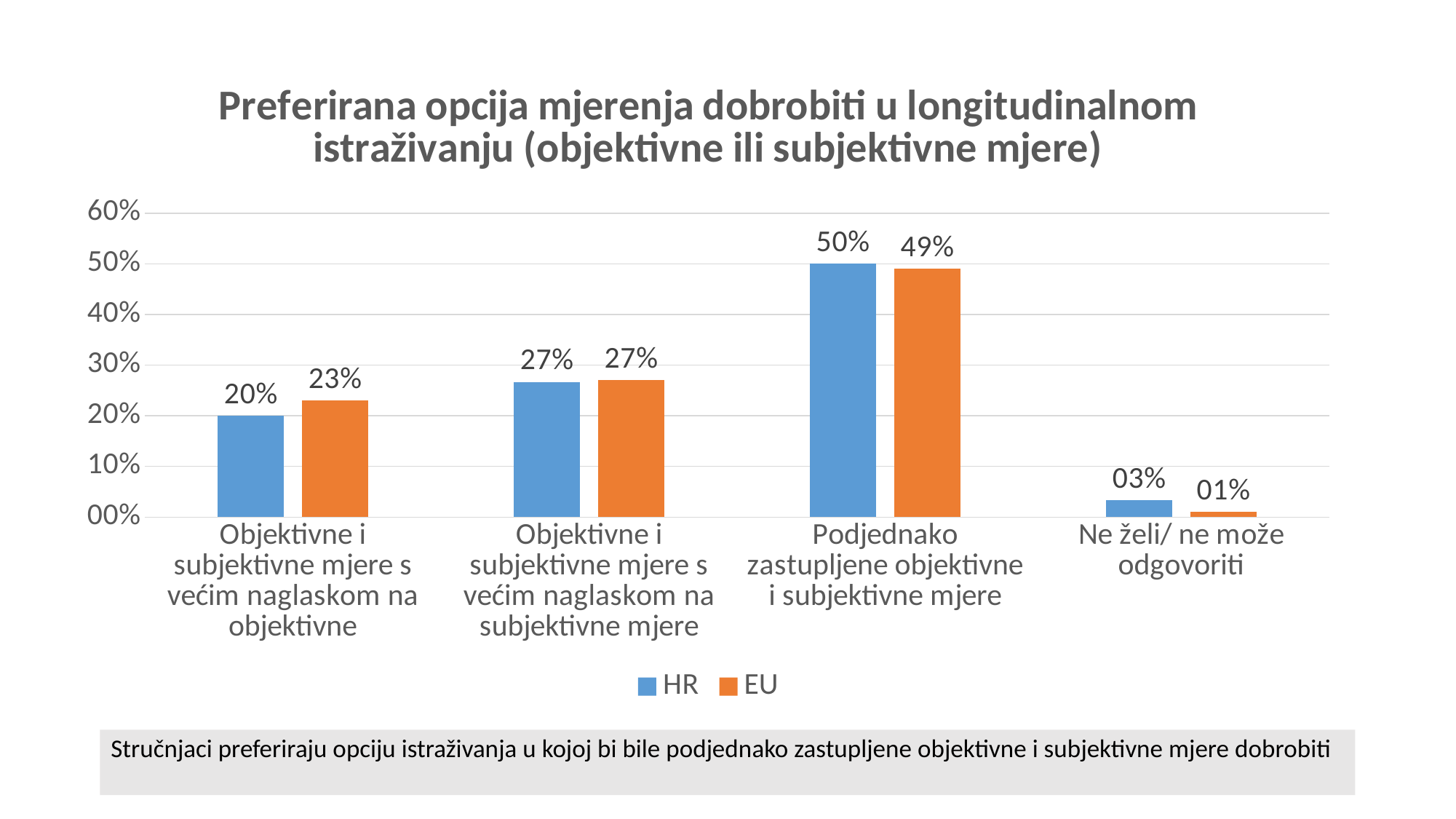
What is the HR value for 'Podjednako zastupljene objektivne i subjektivne mjere'? 50% Which is larger for 'Podjednako zastupljene objektivne i subjektivne mjere': the HR value or the EU value? HR Is the HR value for 'Objektivne i subjektivne mjere s većim naglaskom na subjektivne mjere' greater or less than 30%? less What is the difference between the EU and HR values for 'Objektivne i subjektivne mjere s većim naglaskom na objektivne'? 3% What kind of chart is shown on the slide? Bar chart How many series does the legend list? 2 Which colour represents the EU series? Orange What is the EU value for 'Ne želi/ ne može odgovoriti'? 01% Which category has the highest HR value? Podjednako zastupljene objektivne i subjektivne mjere How many categories are shown on the x axis? 4 Which category has the lowest EU value? Ne želi/ ne može odgovoriti What is the EU value for 'Objektivne i subjektivne mjere s većim naglaskom na objektivne'? 23%